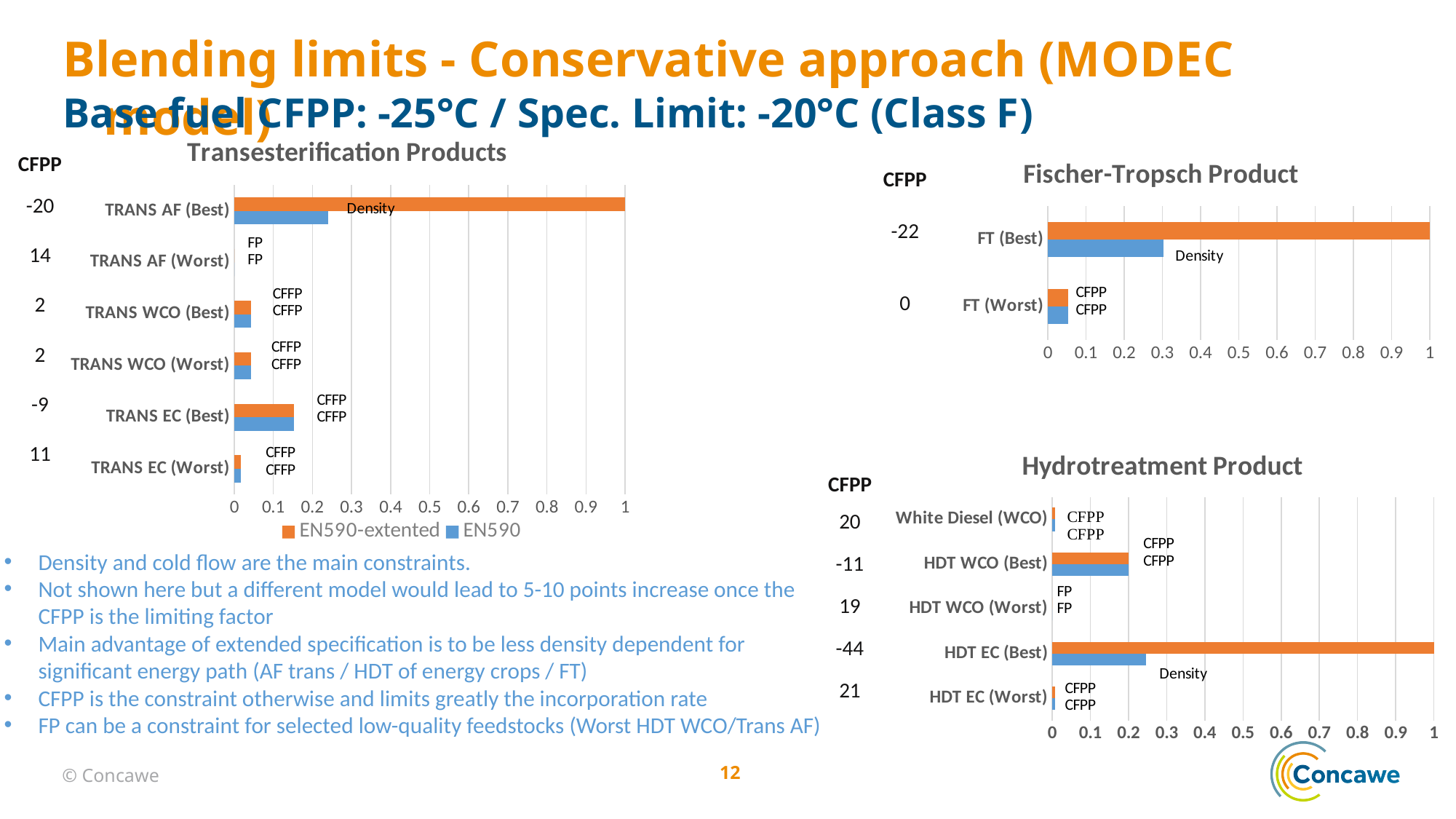
On the Transesterification Products chart, what is the EN590-extented value for TRANS AF (Best)? 1 On the Transesterification Products chart, which category has the highest EN590-extented value? TRANS AF (Best) On the Fischer-Tropsch Product chart, is the EN590 value for FT (Best) greater or less than 0.2? greater On the Transesterification Products chart, is the EN590 value for TRANS EC (Best) greater or less than 0.1? greater On the Transesterification Products chart, which has the larger EN590 value, TRANS AF (Best) or TRANS EC (Best)? TRANS AF (Best) How many categories are shown on the Transesterification Products chart? 6 On the Fischer-Tropsch Product chart, what is the EN590-extented value for FT (Best)? 1 How many series does the legend of the Transesterification Products chart list? 2 On the Transesterification Products chart, which constraint is labelled next to the TRANS AF (Best) bars? Density What kind of chart is the Transesterification Products chart? bar chart How many categories are shown on the Fischer-Tropsch Product chart? 2 On the Hydrotreatment Product chart, which category has the highest EN590-extented value? HDT EC (Best)